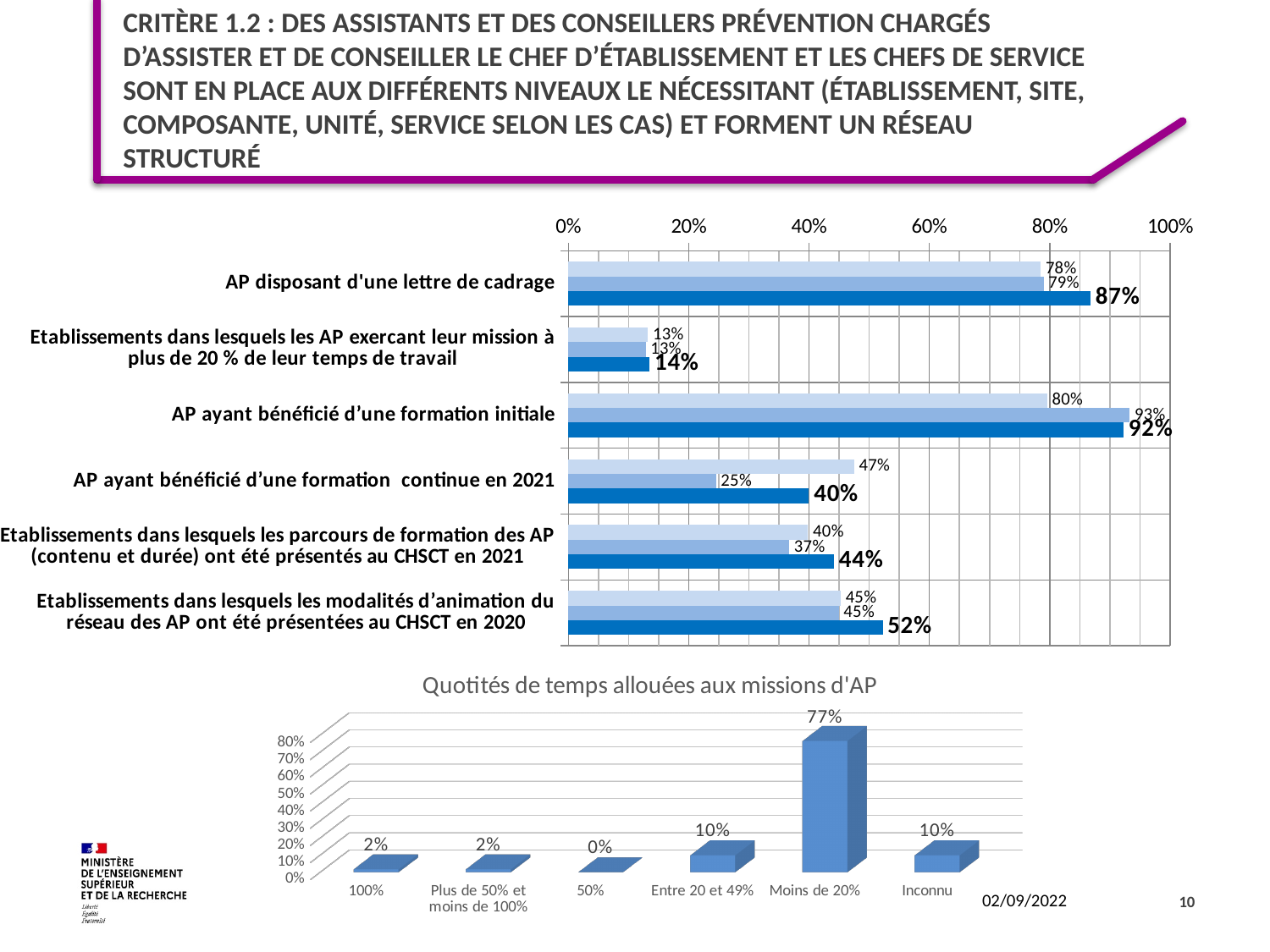
In the bottom chart "Quotités de temps allouées aux missions d'AP", what is the difference between the values for "Moins de 20%" and "Inconnu"? 67% In the bottom chart "Quotités de temps allouées aux missions d'AP", what is the value for "Entre 20 et 49%"? 10% In the bottom chart "Quotités de temps allouées aux missions d'AP", which category has the lowest value? 50% In the top chart, what is the value of the dark blue (bottom) bar for "AP ayant bénéficié d'une formation continue en 2021"? 40% In the top chart, is the dark blue (bottom) bar for "AP ayant bénéficié d'une formation initiale" larger or smaller than the dark blue bar for "AP disposant d'une lettre de cadrage"? Larger In the bottom chart titled "Quotités de temps allouées aux missions d'AP", what is the value for "Moins de 20%"? 77% In the bottom chart "Quotités de temps allouées aux missions d'AP", how many categories are shown on the x axis? 6 In the bottom chart "Quotités de temps allouées aux missions d'AP", which category has the highest value? Moins de 20% In the top chart, what is the value of the dark blue (bottom) bar for "AP disposant d'une lettre de cadrage"? 87% What kind of chart is the top chart on the slide? Bar chart In the top chart, how many categories are listed on the vertical axis? 6 In the top chart, which category has the lowest dark blue (bottom) bar value? Etablissements dans lesquels les AP exercant leur mission à plus de 20 % de leur temps de travail